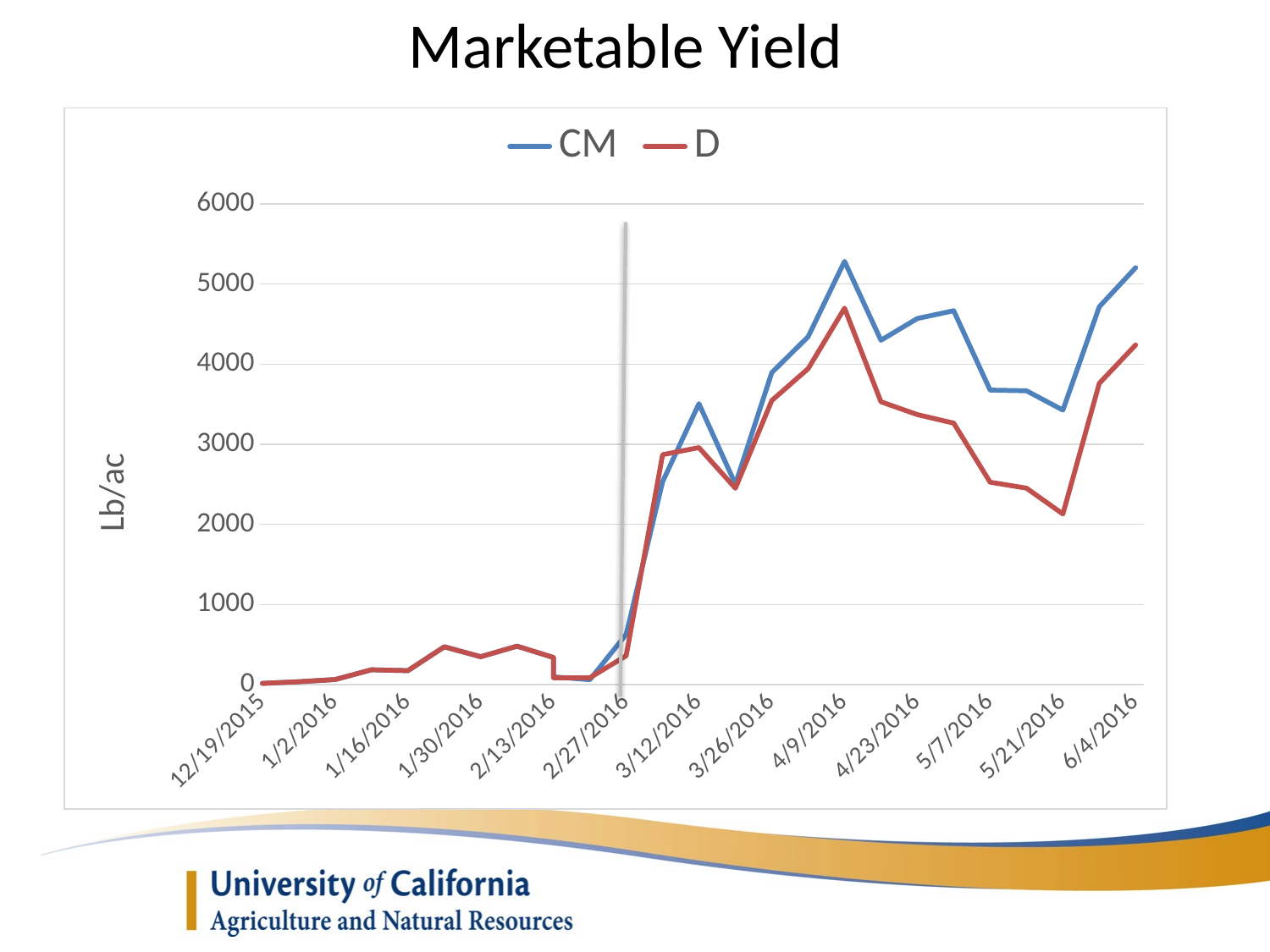
Does the D series rise or fall between 4/9/2016 and 5/21/2016? fall Is the value for CM at 6/4/2016 greater or less than 5000? greater How many date labels are shown on the x axis? 13 What is the title of the chart? Marketable Yield At 6/4/2016, which series has the larger value, CM or D? CM How many series does the legend list? 2 Is the value for D at 1/30/2016 greater or less than 1000? less Which series reaches the highest value on the chart? CM What kind of chart is shown on the slide? line chart What is the label on the y axis? Lb/ac Is the value for D at 5/21/2016 greater or less than 3000? less